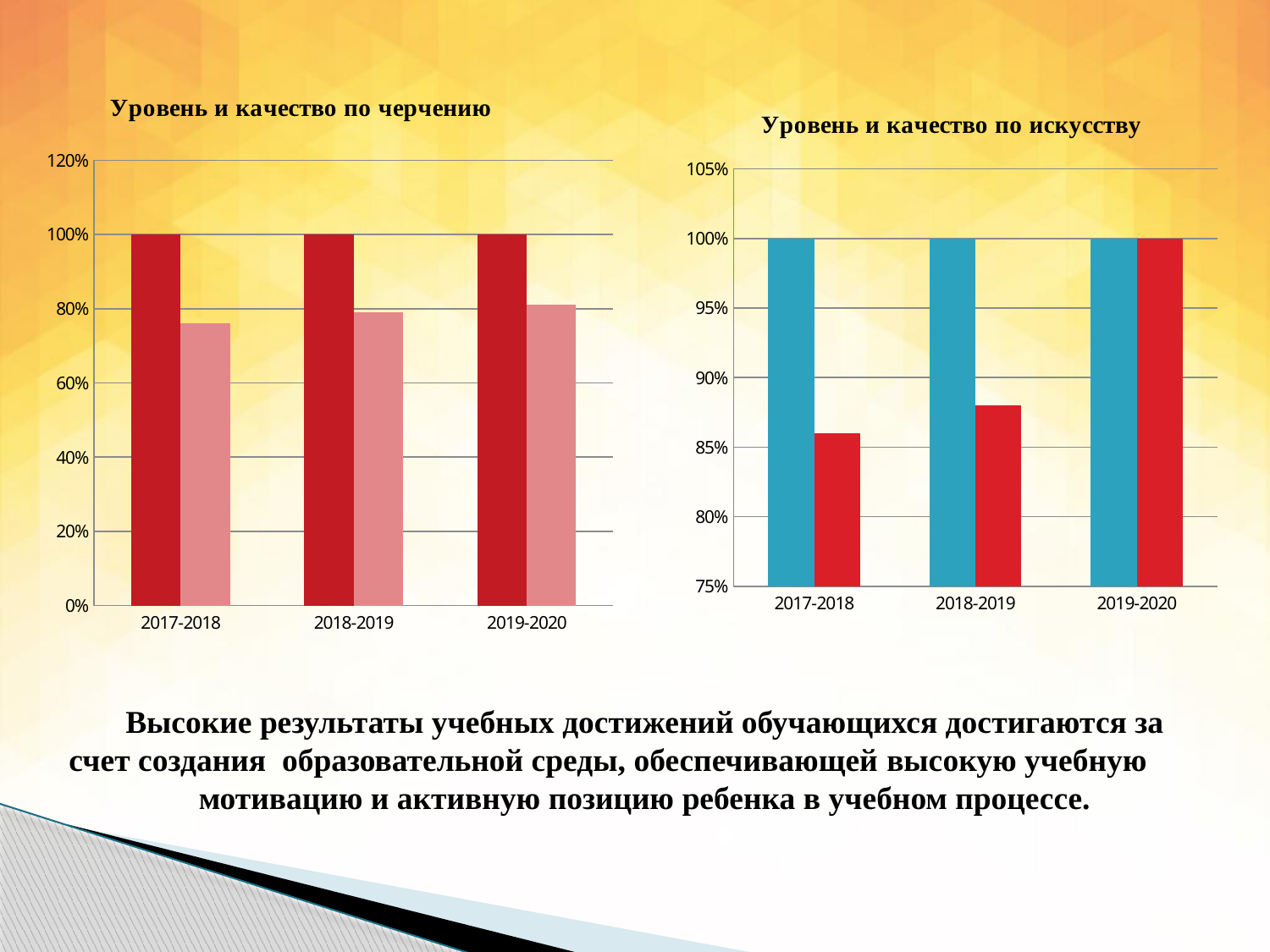
In the 'Уровень и качество по искусству' chart, which is larger for 2017-2018: the blue bar or the red bar? the blue bar In the 'Уровень и качество по черчению' chart, is the pink bar for 2017-2018 greater or less than 80%? less In the 'Уровень и качество по искусству' chart, what value does the red bar for 2019-2020 reach? 100% In the 'Уровень и качество по искусству' chart, is the red bar for 2018-2019 greater or less than 85%? greater In the 'Уровень и качество по искусству' chart, which year has the lowest red bar? 2017-2018 How many categories are shown on the x axis of the 'Уровень и качество по искусству' chart? 3 In the 'Уровень и качество по искусству' chart, is the red bar for 2017-2018 greater or less than 90%? less What is the title of the chart on the right side of the slide? Уровень и качество по искусству What kind of chart is 'Уровень и качество по черчению'? bar chart In the 'Уровень и качество по черчению' chart, do the pink bars rise or fall from 2017-2018 to 2019-2020? rise In the 'Уровень и качество по черчению' chart, what value does the dark red bar for 2018-2019 reach? 100%